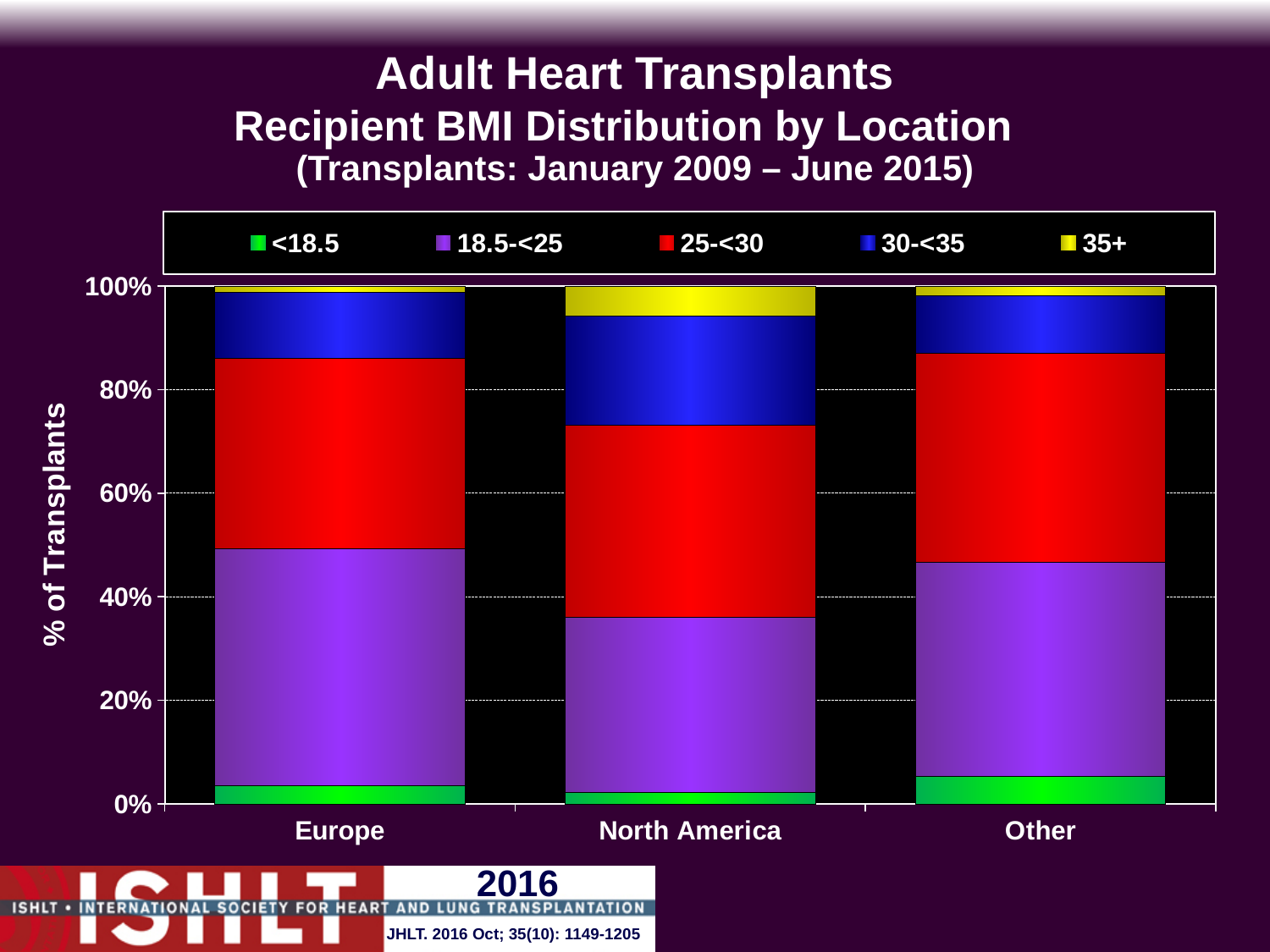
What kind of chart is shown on the slide? stacked bar chart Which location has the smallest share of recipients with BMI 18.5-<25? North America How many locations are shown on the x axis? 3 Which location has the largest share of recipients with BMI 35+? North America What do the segments of each stacked bar add up to? 100% Is the share of recipients with BMI <18.5 in Other greater or less than 20%? less Which location has the largest share of recipients with BMI 30-<35? North America Is the share of recipients with BMI 18.5-<25 in Europe greater or less than 40%? greater What is the label on the y axis? % of Transplants Which is larger: the 30-<35 share in North America or the 30-<35 share in Other? North America How many BMI categories does the legend list? 5 Is the share of recipients with BMI 18.5-<25 in North America greater or less than 40%? less